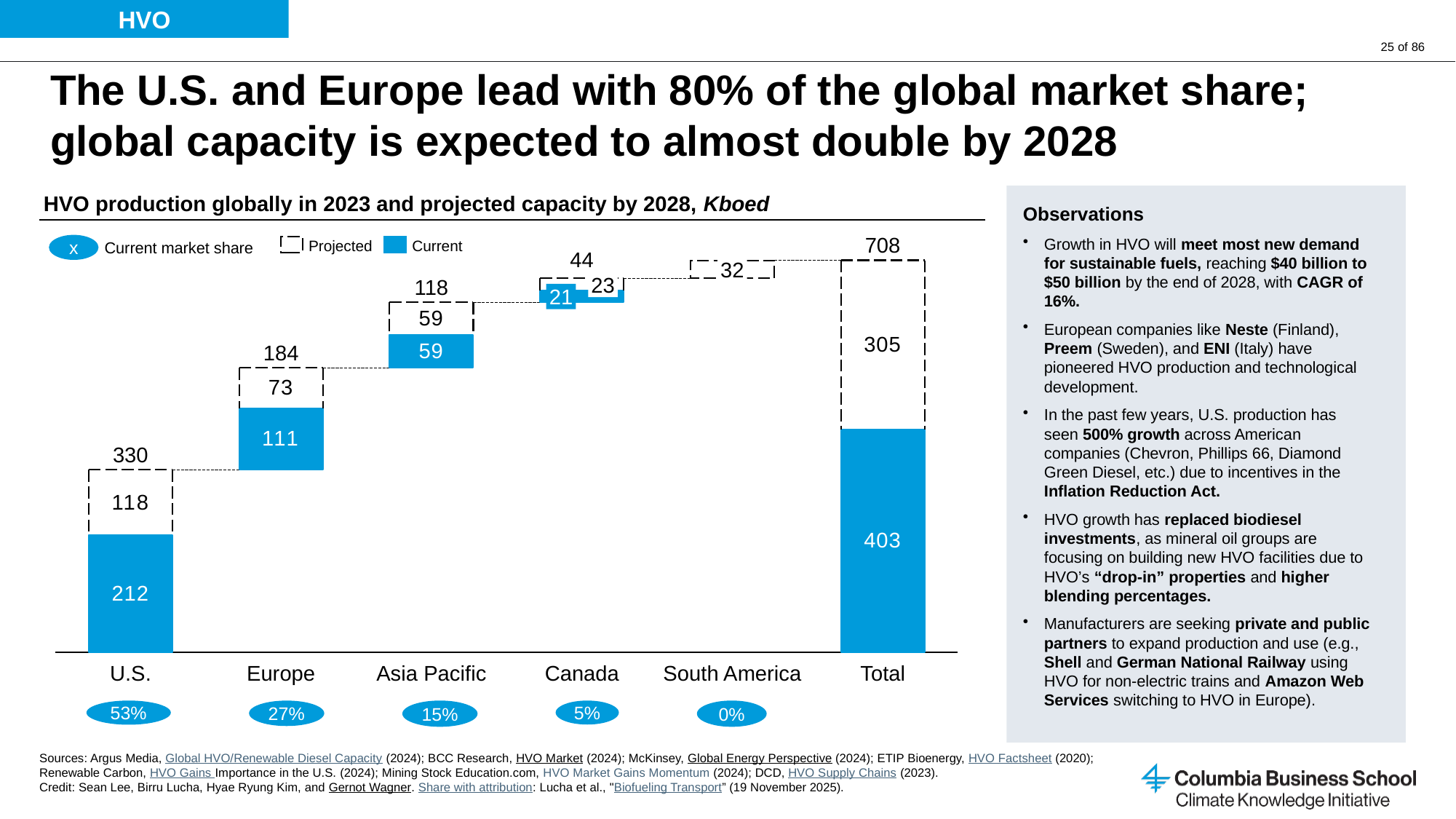
What is the projected capacity value shown for South America? 32 Which region has the highest current HVO production? U.S. What is the current market share shown for Canada? 5% What is the current HVO production value shown for the U.S.? 212 What is the projected additional capacity shown for Europe? 73 What is the total (current plus projected) value labelled above the Asia Pacific bar? 118 Which region has the lowest current market share shown in the ovals below the axis? South America What unit is given in the chart title for the values? Kboed What is the difference between the current production of the U.S. (212) and Europe (111)? 101 How many regions (excluding Total) are shown on the x axis? 5 Is the current production for Europe larger or smaller than the current production for Asia Pacific? larger What is the total value labelled above the Total bar? 708